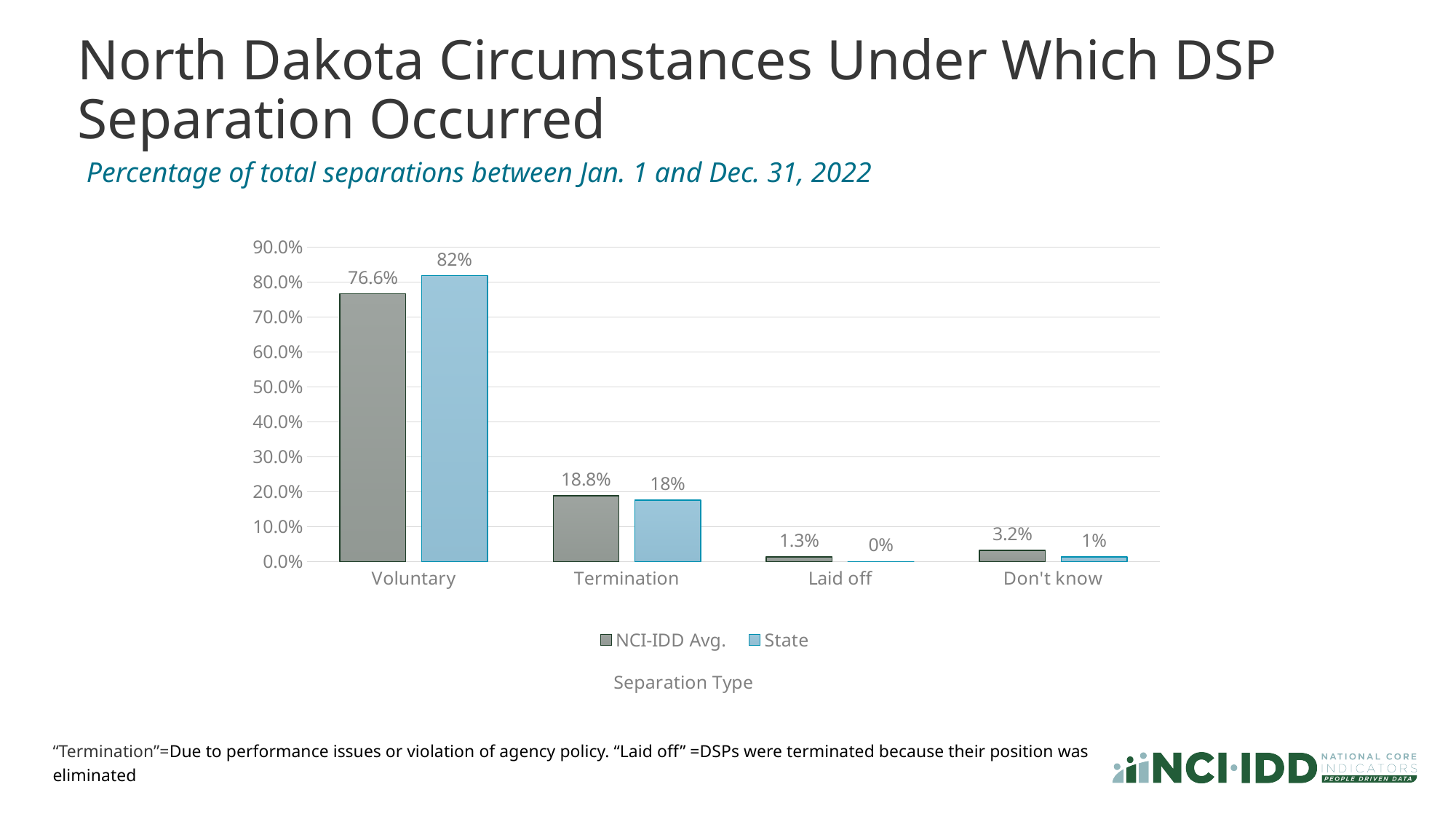
What is the label of the x axis? Separation Type What is the NCI-IDD Avg. value for Termination? 18.8% What kind of chart is shown on the slide? Bar chart How many separation types are shown on the x axis? 4 How many series does the legend list? 2 Which separation type has the highest State value? Voluntary What is the difference between the State and NCI-IDD Avg. values for Voluntary? 5.4% What is the State value for Voluntary separations? 82% Which separation type has the lowest NCI-IDD Avg. value? Laid off What is the State value for Laid off? 0% For Don't know, which is larger: the NCI-IDD Avg. value or the State value? NCI-IDD Avg. What is the NCI-IDD Avg. value for Don't know? 3.2%